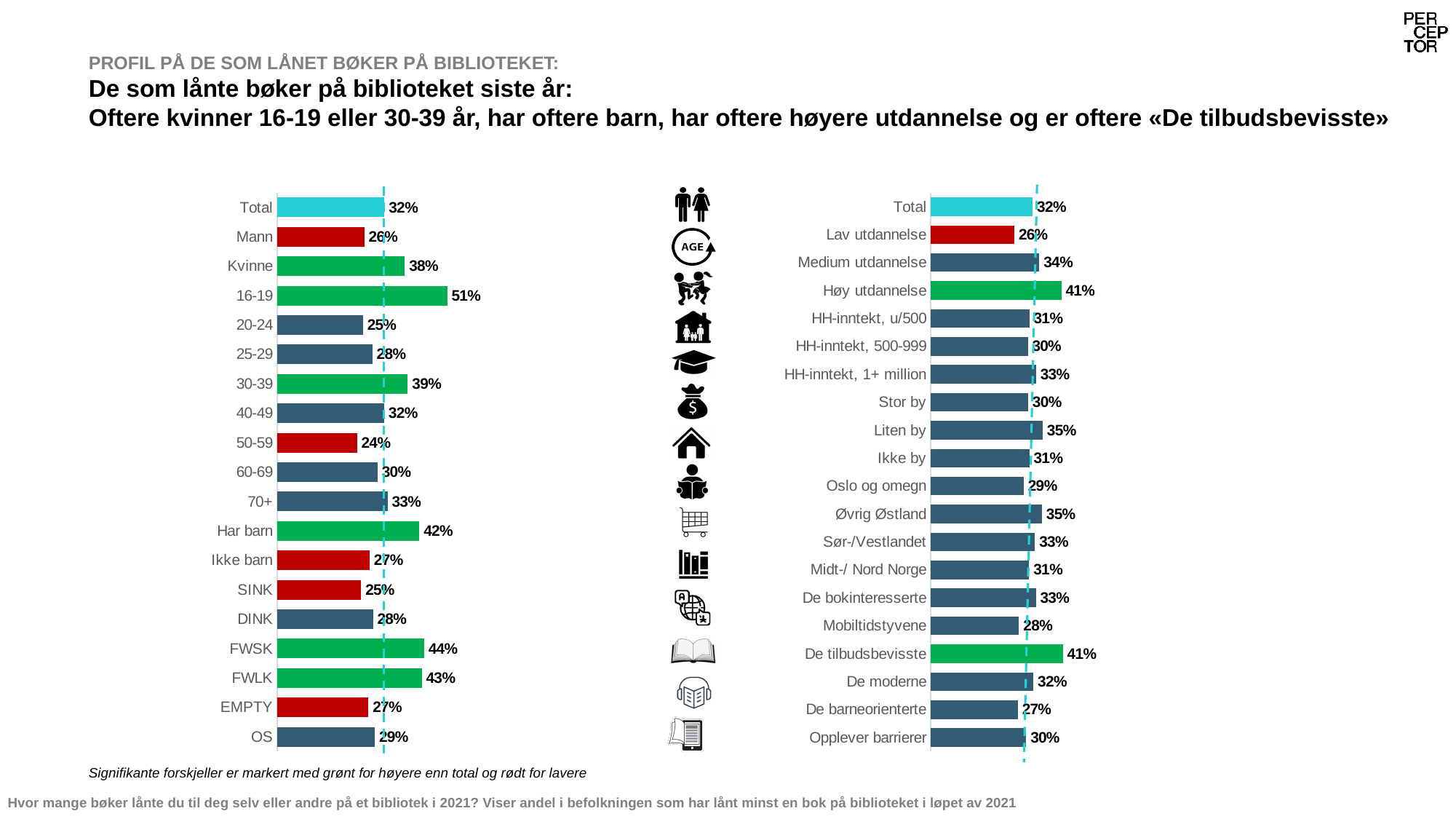
In the left chart, what is the value for Kvinne? 38% What type of chart is the left chart? Bar chart In the left chart, what is the difference between the values for Kvinne and Mann? 12% In the right chart, which is larger, the value for Mobiltidstyvene or the value for De bokinteresserte? De bokinteresserte How many categories are shown in the left chart? 19 In the left chart, what is the value for Har barn? 42% In the right chart, what is the value for Liten by? 35% In the right chart, which category has the lowest value? Lav utdannelse In the left chart, which category has the lowest value? 50-59 In the left chart, which category has the highest value? 16-19 How many categories are shown in the right chart? 20 In the right chart, what is the value for Høy utdannelse? 41%